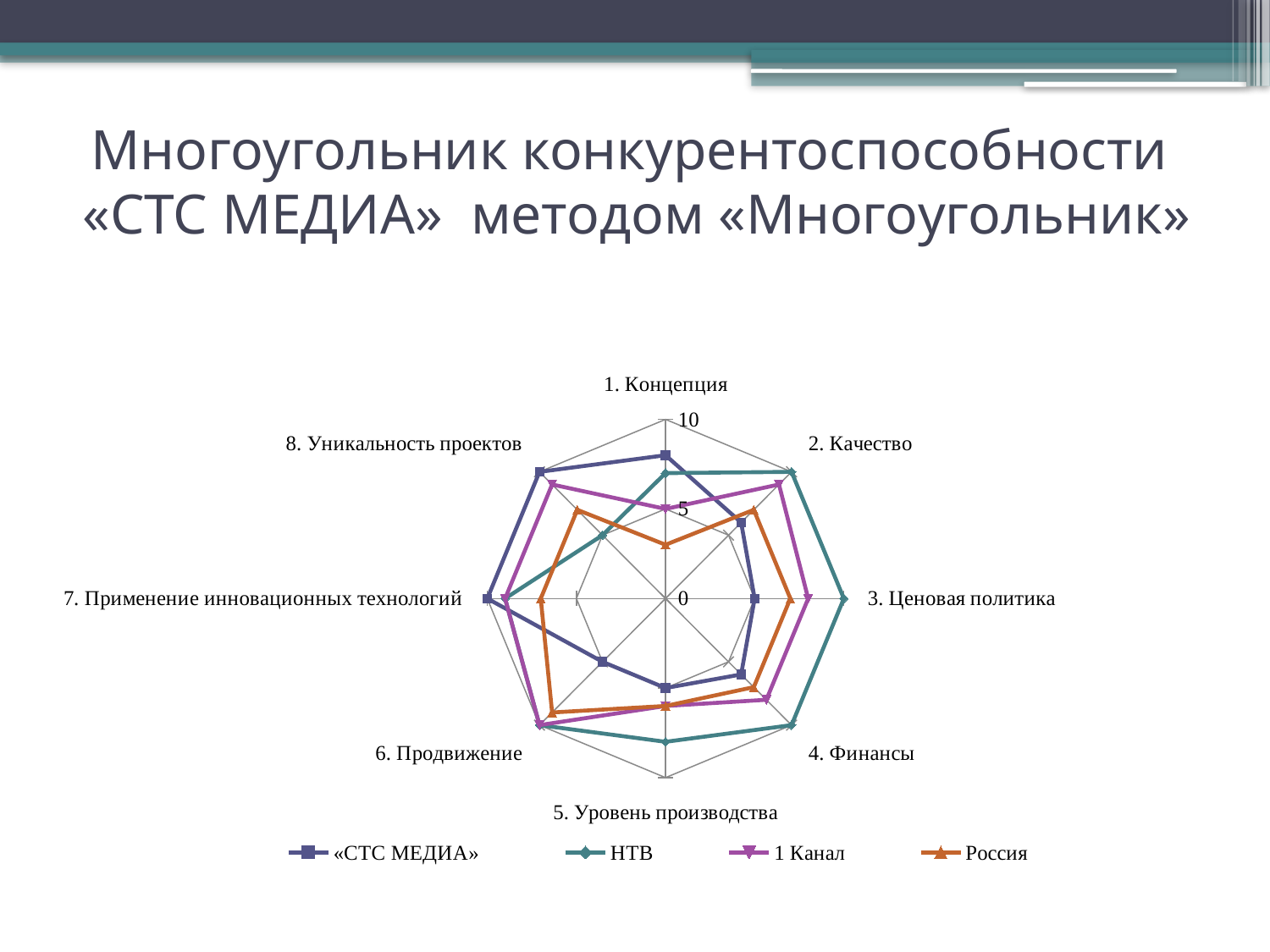
How many series does the legend list? 4 Is the value of НТВ for 3. Ценовая политика greater or less than 5? greater How many categories (axes) does the radar chart have? 8 For 7. Применение инновационных технологий, which is larger: the value of «СТС МЕДИА» or the value of НТВ? «СТС МЕДИА» Which series are listed in the legend? «СТС МЕДИА», НТВ, 1 Канал, Россия What kind of chart is shown on the slide? Radar chart What is the maximum value shown on the radar chart's axis scale? 10 Is the value of Россия for 6. Продвижение greater or less than 5? greater Which series has the highest value for 1. Концепция? «СТС МЕДИА» Is the value of «СТС МЕДИА» for 1. Концепция greater or less than 5? greater Which series has the lowest value for 1. Концепция? Россия